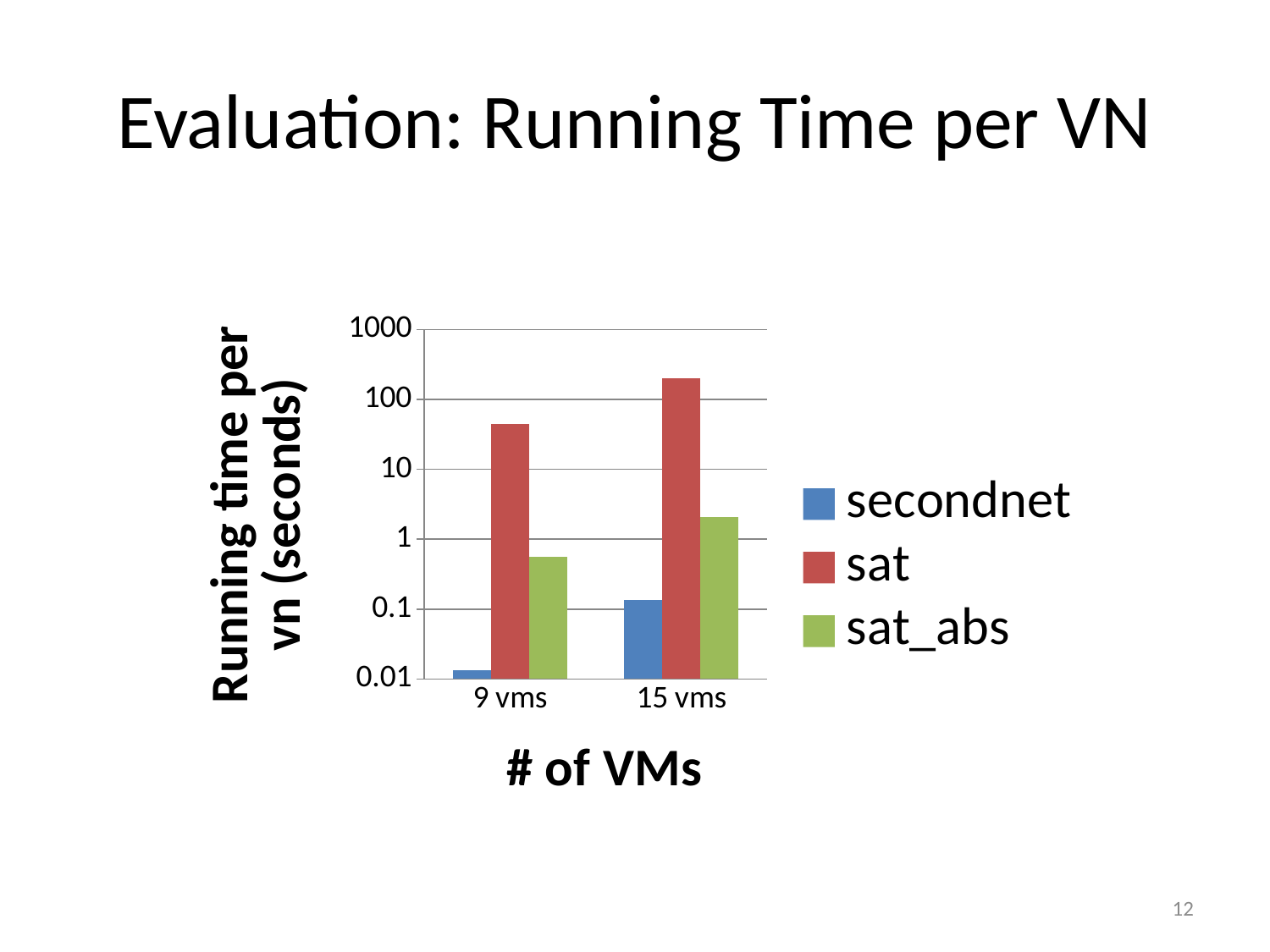
Is the value for sat at 15 vms greater or less than 100? greater How many series does the legend list? 3 What kind of chart is shown on the slide? bar chart Does the running time for sat_abs rise or fall from 9 vms to 15 vms? rise Which series has the lowest running time for 15 vms? secondnet Which series has the highest running time for 9 vms? sat Is the value for sat at 9 vms greater or less than 10? greater Which is larger: the sat value at 9 vms or the sat value at 15 vms? 15 vms Is the value for sat_abs at 9 vms greater or less than 1? less What is the label of the y axis? Running time per vn (seconds) How many categories are shown on the x axis? 2